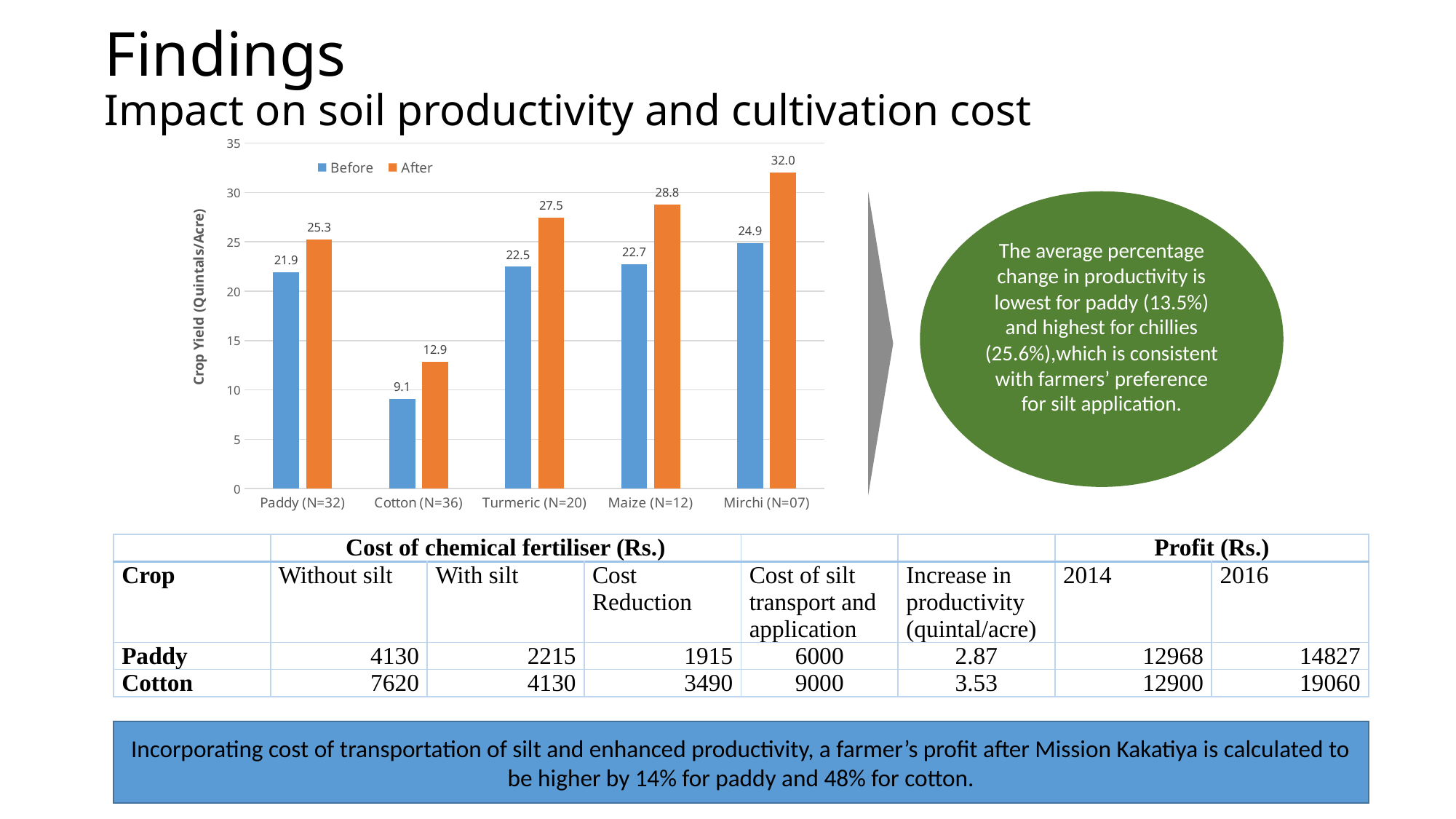
Which crop has the highest 'After' yield? Mirchi (N=07) What is the 'Before' crop yield for Cotton (N=36)? 9.1 What is the 'After' crop yield for Mirchi (N=07)? 32.0 What is the 'After' crop yield for Turmeric (N=20)? 27.5 Which crop has the lowest 'Before' yield? Cotton (N=36) What is the difference between the 'After' and 'Before' yields for Maize (N=12)? 6.1 What is the label of the y axis of the chart? Crop Yield (Quintals/Acre) Which is larger, the 'Before' yield for Paddy (N=32) or the 'Before' yield for Mirchi (N=07)? Mirchi (N=07) What kind of chart is shown on the slide? bar chart How many series does the chart legend list? 2 Is the 'After' yield for Cotton (N=36) greater or less than 15? less How many crops are shown on the x axis of the chart? 5